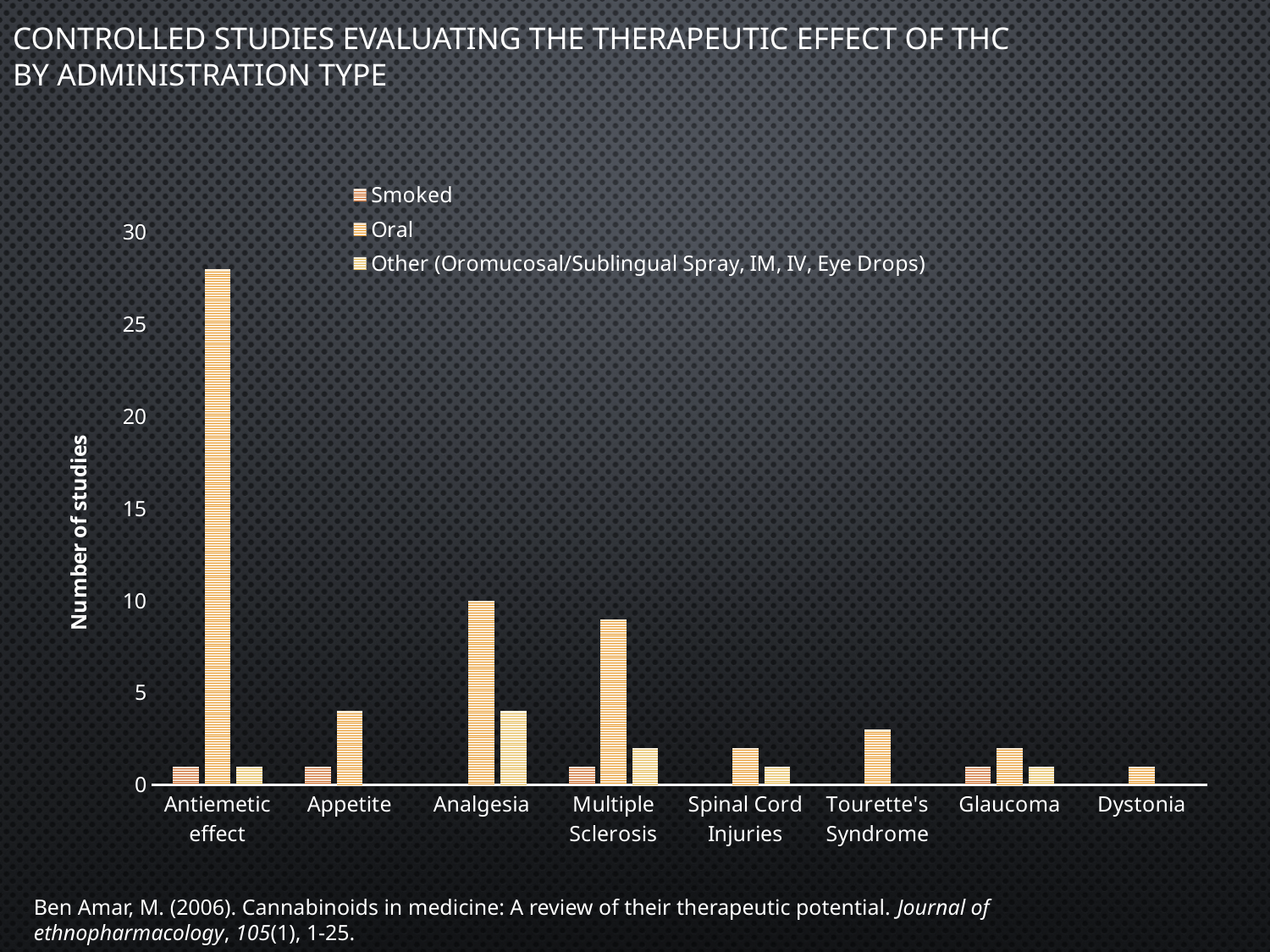
How many series does the legend list? 3 Is the Oral value for Multiple Sclerosis greater or less than 10? less What is the title of the y axis? Number of studies What type of chart is shown on the slide? bar chart Which is larger, the Oral value for Appetite or the Oral value for Spinal Cord Injuries? Appetite Which is larger, the Oral value for Antiemetic effect or the Oral value for Analgesia? Antiemetic effect Which category has the highest Oral value? Antiemetic effect Is the Oral value for Antiemetic effect greater or less than 25? greater How many categories are shown on the x axis? 8 What is the third legend entry? Other (Oromucosal/Sublingual Spray, IM, IV, Eye Drops) What is the Oral value for Analgesia? 10 Is the Oral value for Appetite greater or less than 5? less